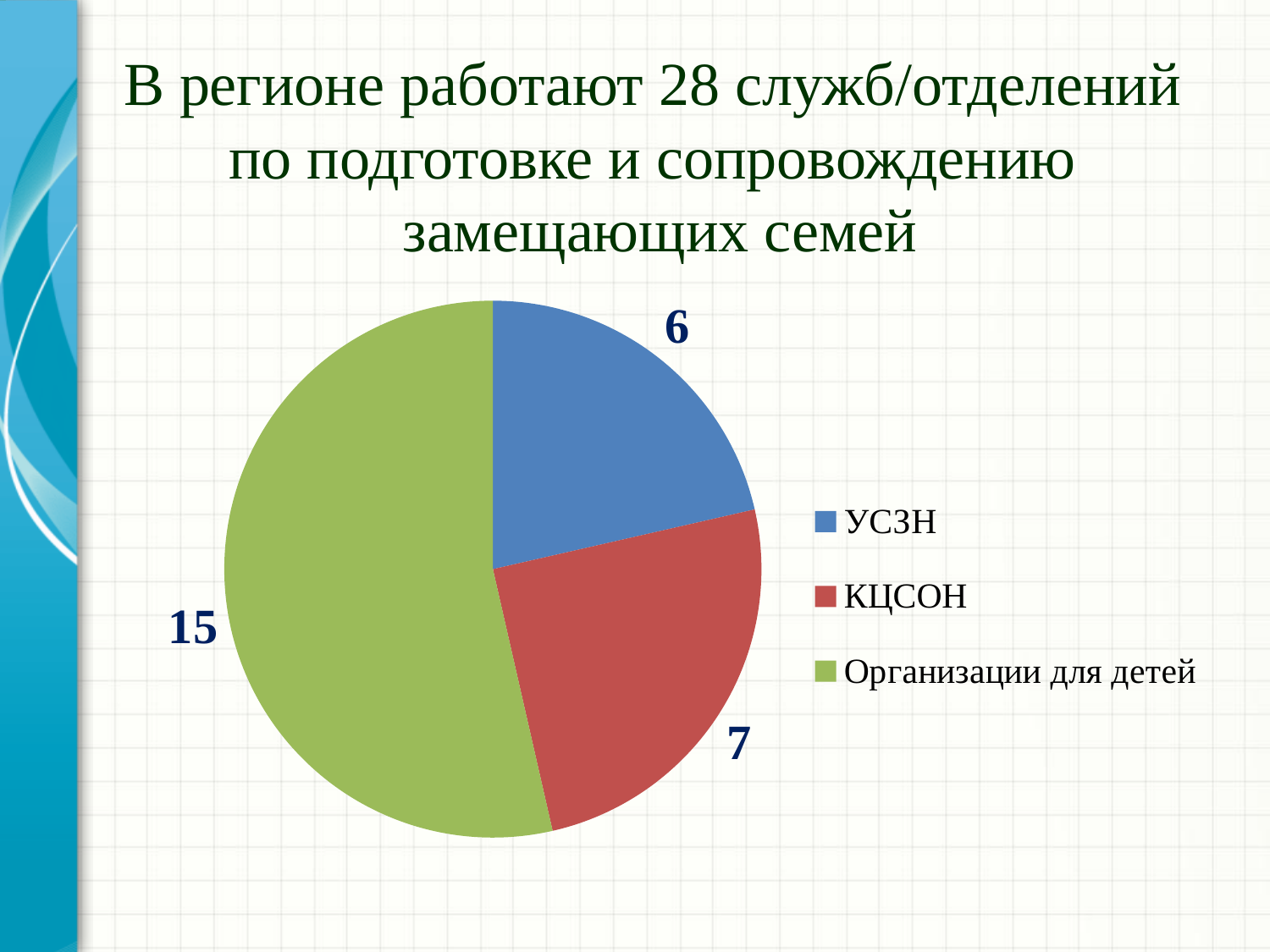
What is the value for Организации для детей? 15 What is the total of all slices in the pie chart? 28 What colour is the slice for Организации для детей? green What is the difference between the values for Организации для детей and КЦСОН? 8 Which category has the smallest slice? УСЗН What is the value for УСЗН? 6 How many entries does the legend list? 3 How many slices does the pie chart have? 3 Which category has the largest slice? Организации для детей What is the value for КЦСОН? 7 What kind of chart is shown on the slide? pie chart Which is larger, the value for КЦСОН or the value for УСЗН? КЦСОН